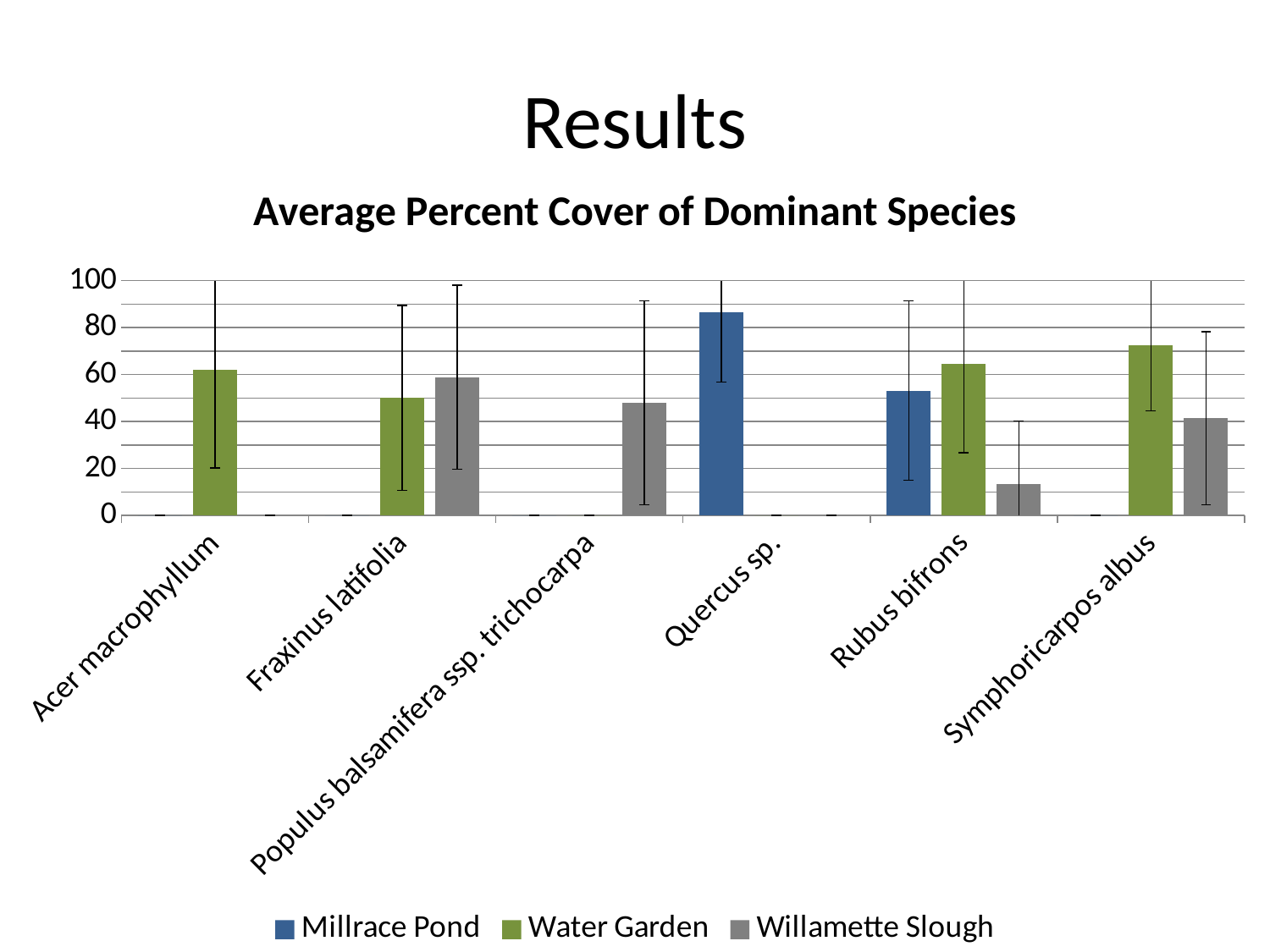
Is the Willamette Slough value for Populus balsamifera ssp. trichocarpa greater or less than 60? less What kind of chart is shown on the slide? bar chart Is the Water Garden value for Acer macrophyllum greater or less than 40? greater Is the Willamette Slough value for Rubus bifrons greater or less than 20? less For Symphoricarpos albus, which site has the larger value: Water Garden or Willamette Slough? Water Garden How many species categories are shown on the x axis? 6 Which species and site combination has the tallest bar in the chart? Quercus sp., Millrace Pond For Rubus bifrons, which site has the larger value: Millrace Pond or Water Garden? Water Garden Which species has the highest Water Garden value? Symphoricarpos albus How many series does the legend list? 3 What is the title of the chart? Average Percent Cover of Dominant Species